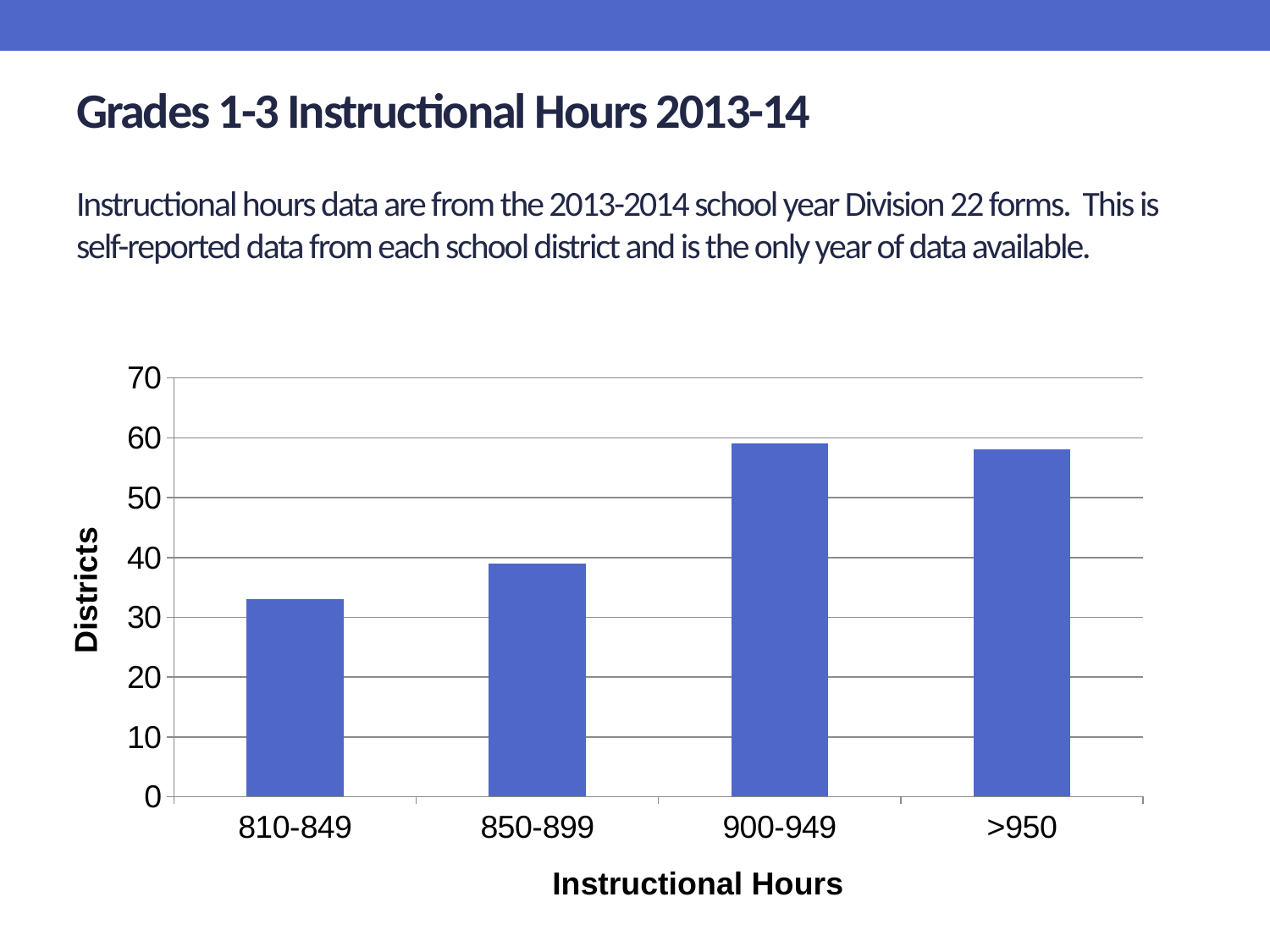
How many instructional-hour categories are shown on the x axis? 4 Which has more districts, 810-849 or 850-899? 850-899 Is the number of districts for 900-949 greater or less than 50? greater Which instructional-hours category has the lowest number of districts? 810-849 What is the label of the horizontal axis? Instructional Hours What kind of chart is shown on the slide? bar chart Is the number of districts for 810-849 greater or less than 30? greater Is the number of districts for >950 greater or less than 60? less Which has more districts, 850-899 or 900-949? 900-949 What is the label of the vertical axis? Districts